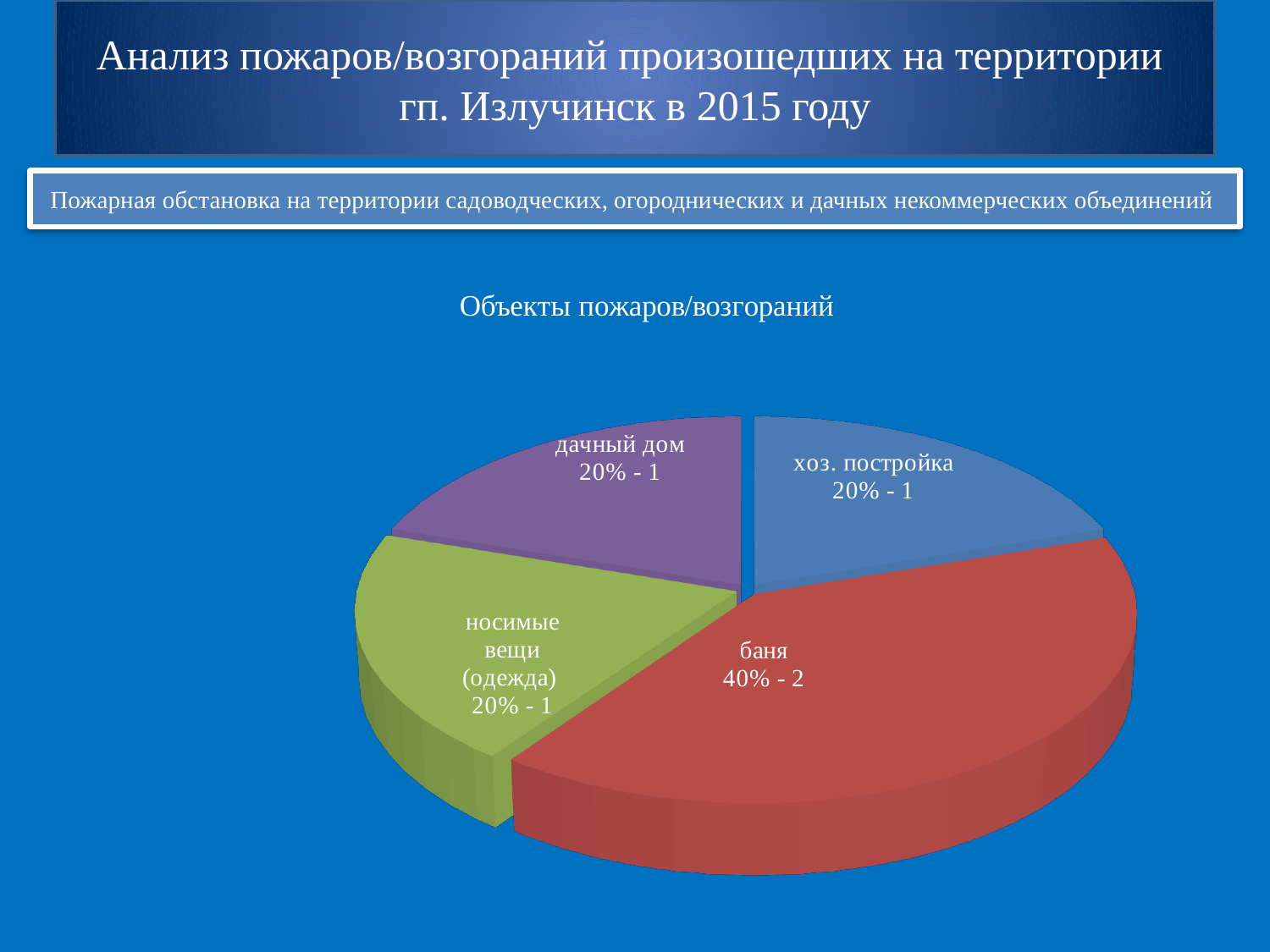
What is the title of the chart? Объекты пожаров/возгораний Which is larger, the share for "баня" or the share for "дачный дом"? баня How many fires are recorded for "дачный дом"? 1 What colour is the slice for "баня"? red How many fires are recorded for "баня"? 2 What share of the pie does the slice "хоз. постройка" represent? 20% How many fires are recorded for "носимые вещи (одежда)"? 1 What is the difference in the number of fires between "баня" and "хоз. постройка"? 1 What kind of chart is shown on the slide? pie chart What share of the pie does the slice "баня" represent? 40% Which category has the largest slice of the pie? баня How many slices does the pie chart have? 4